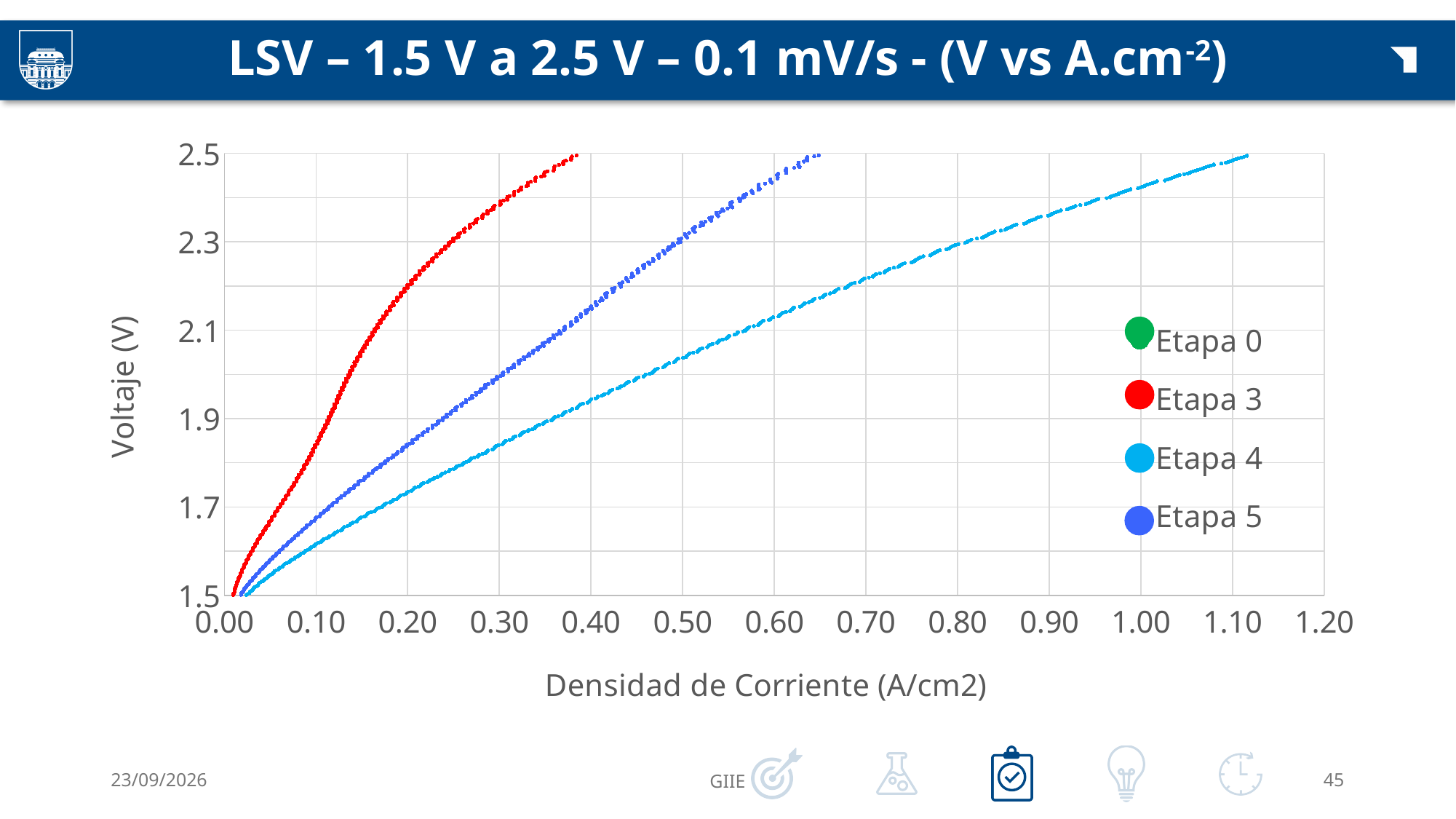
Which series reaches the highest current density at 2.5 V? Etapa 4 What is the title of the chart? LSV – 1.5 V a 2.5 V – 0.1 mV/s - (V vs A.cm-2) Does the voltage rise or fall as current density increases along the x axis? rise Is the current density reached by Etapa 3 at 2.5 V greater or less than 0.40? less What is the label of the x axis? Densidad de Corriente (A/cm2) Is the current density reached by Etapa 5 at 2.5 V greater or less than 0.60? greater What kind of chart is shown on the slide? scatter chart Is the current density reached by Etapa 4 at 2.5 V greater or less than 1.00? greater How many series does the legend list? 4 Which of the plotted series reaches the lowest current density at 2.5 V? Etapa 3 At 2.5 V, which reaches a higher current density, Etapa 5 or Etapa 3? Etapa 5 At a current density of 0.20, which series has the higher voltage, Etapa 3 or Etapa 4? Etapa 3